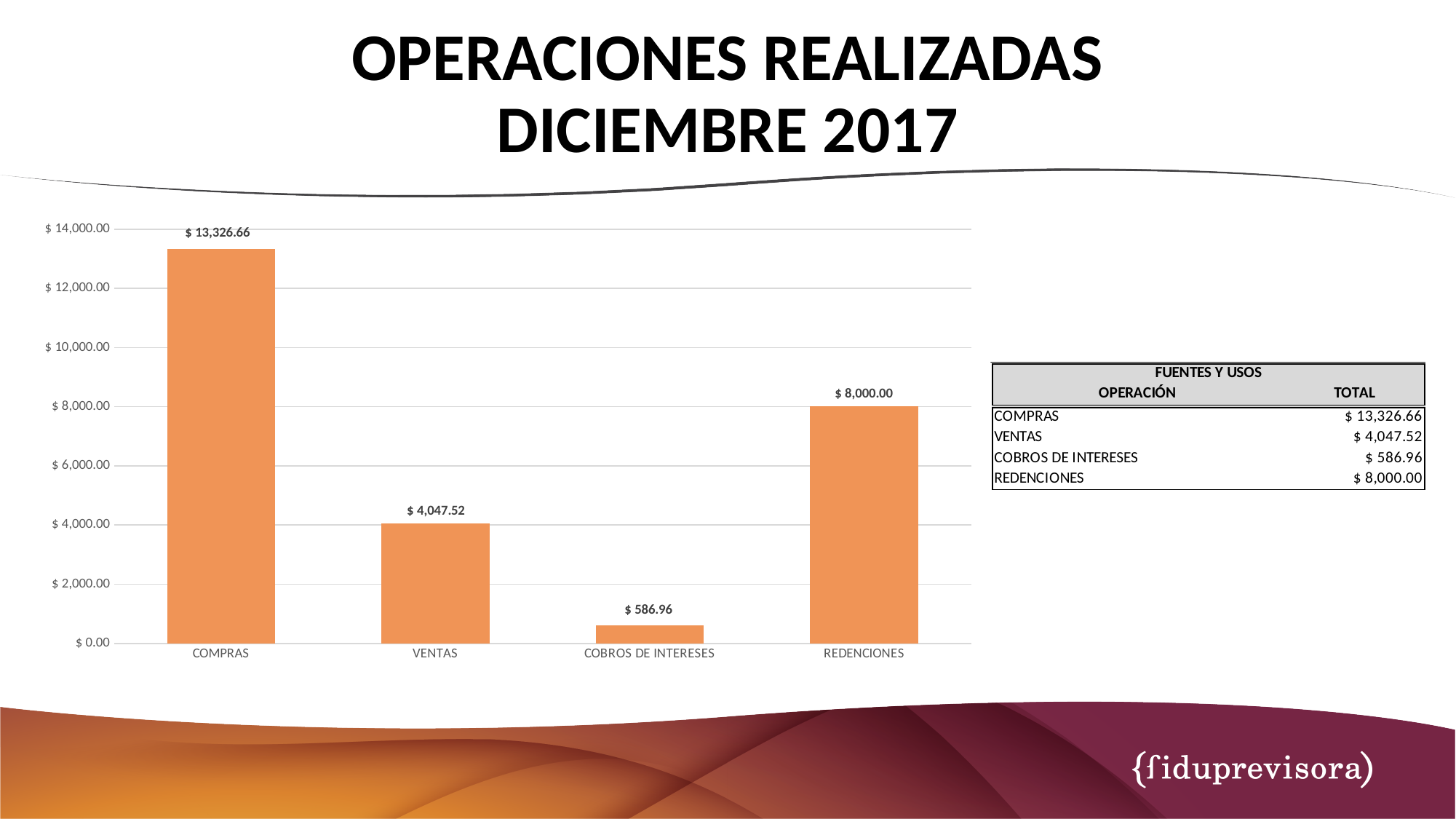
What is the value for VENTAS? $ 4,047.52 What is the value for REDENCIONES? $ 8,000.00 Is the value for VENTAS greater or less than $ 6,000.00? less What is the value for COBROS DE INTERESES? $ 586.96 How many categories are shown on the x axis of the chart? 4 Which category has the lowest value? COBROS DE INTERESES What is the value for COMPRAS? $ 13,326.66 What is the difference between the values for COMPRAS and REDENCIONES? $ 5,326.66 Which is larger, the value for VENTAS or the value for REDENCIONES? REDENCIONES What kind of chart is shown on the slide? bar chart What is the difference between the values for VENTAS and COBROS DE INTERESES? $ 3,460.56 Which category has the highest value? COMPRAS